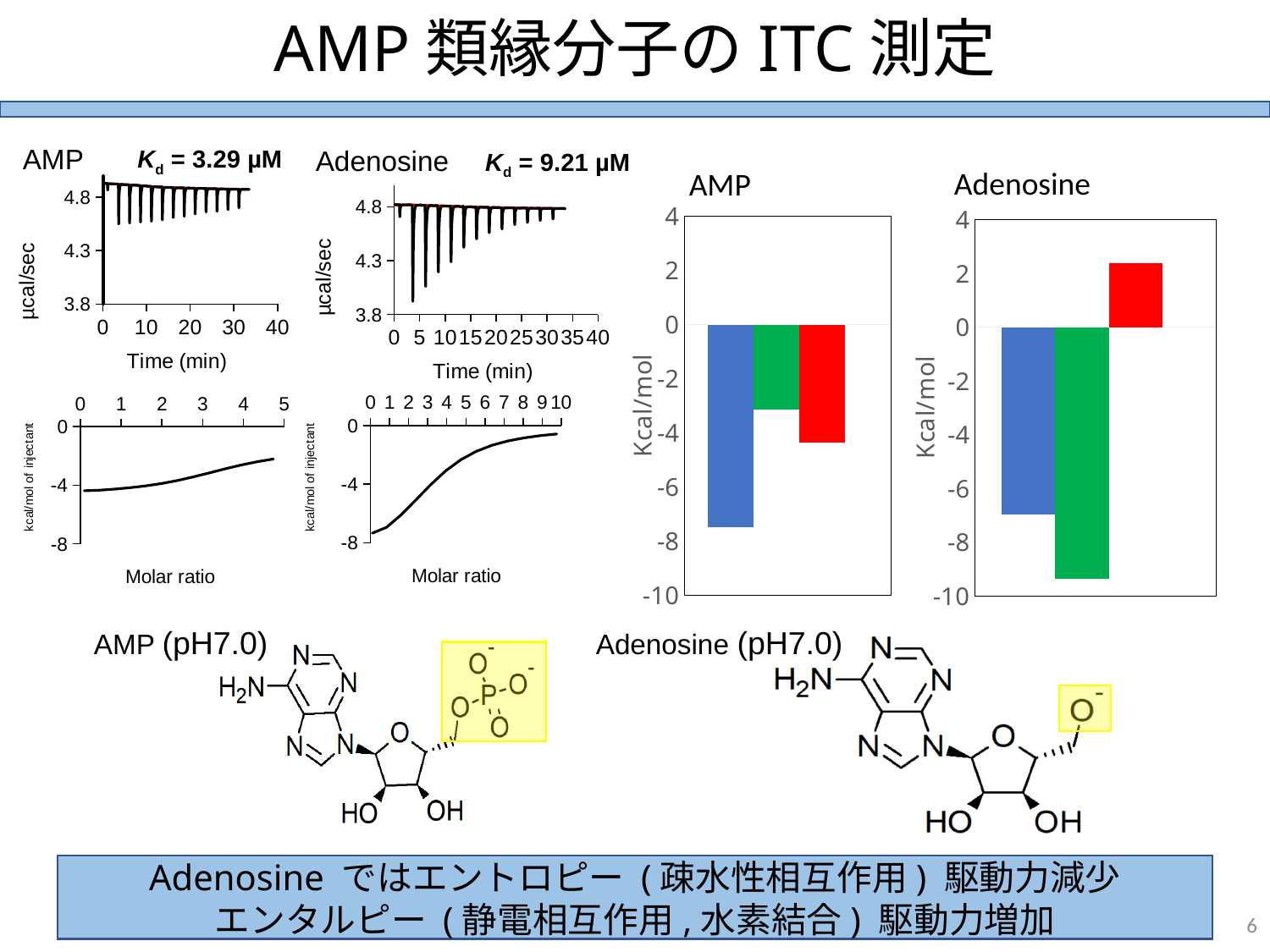
In the "AMP" bar chart, which is larger, the value of the green bar or the value of the blue bar? the green bar In the "Adenosine" bar chart, is the value of the blue bar greater or less than -6? less What is the y-axis label of the "AMP" bar chart? Kcal/mol What kind of chart is the chart titled "AMP" on the right side of the slide? bar chart In the "Adenosine" bar chart, which bar has the lowest (most negative) value? the green bar In the "AMP" bar chart, is the value of the green bar greater or less than -4? greater In the "Adenosine" bar chart, which bar has the highest value? the red bar In the "Adenosine" bar chart, is the value of the red bar greater or less than 0? greater In the "AMP" bar chart, which bar has the lowest (most negative) value? the blue bar How many bars are plotted in the "Adenosine" bar chart? 3